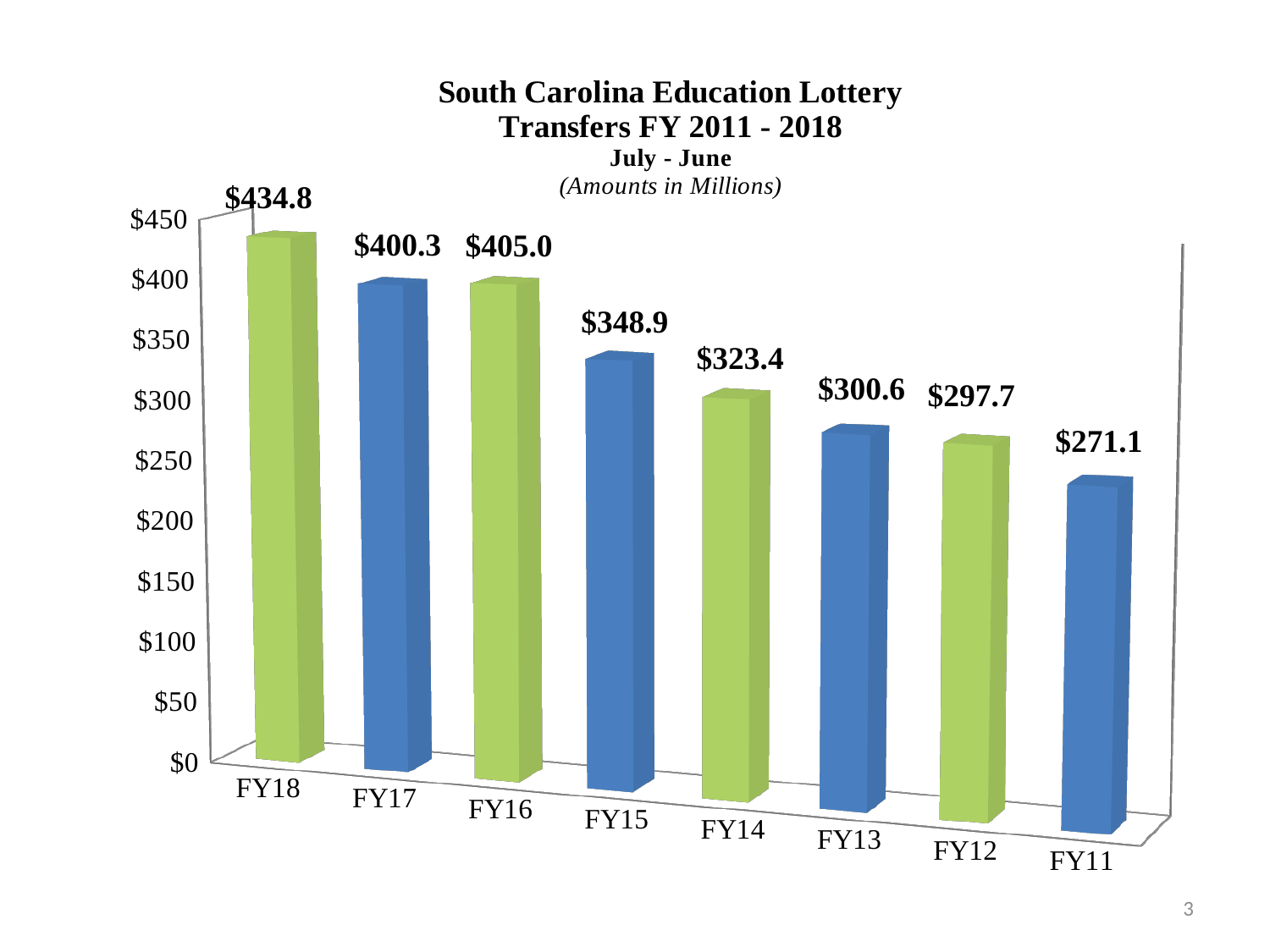
Which fiscal year has the lowest transfer amount? FY11 What is the difference between the values for FY18 and FY11? $163.7 What is the value for FY15? $348.9 What is the title of the chart? South Carolina Education Lottery Transfers FY 2011 - 2018 What is the difference between the values for FY16 and FY17? $4.7 Is the value for FY12 greater or less than $250? greater What is the value for FY18? $434.8 How many fiscal years are shown on the chart? 8 What is the value for FY11? $271.1 Which fiscal year has the highest transfer amount? FY18 What kind of chart is shown on the slide? bar chart Which is larger, the value for FY14 or the value for FY13? FY14